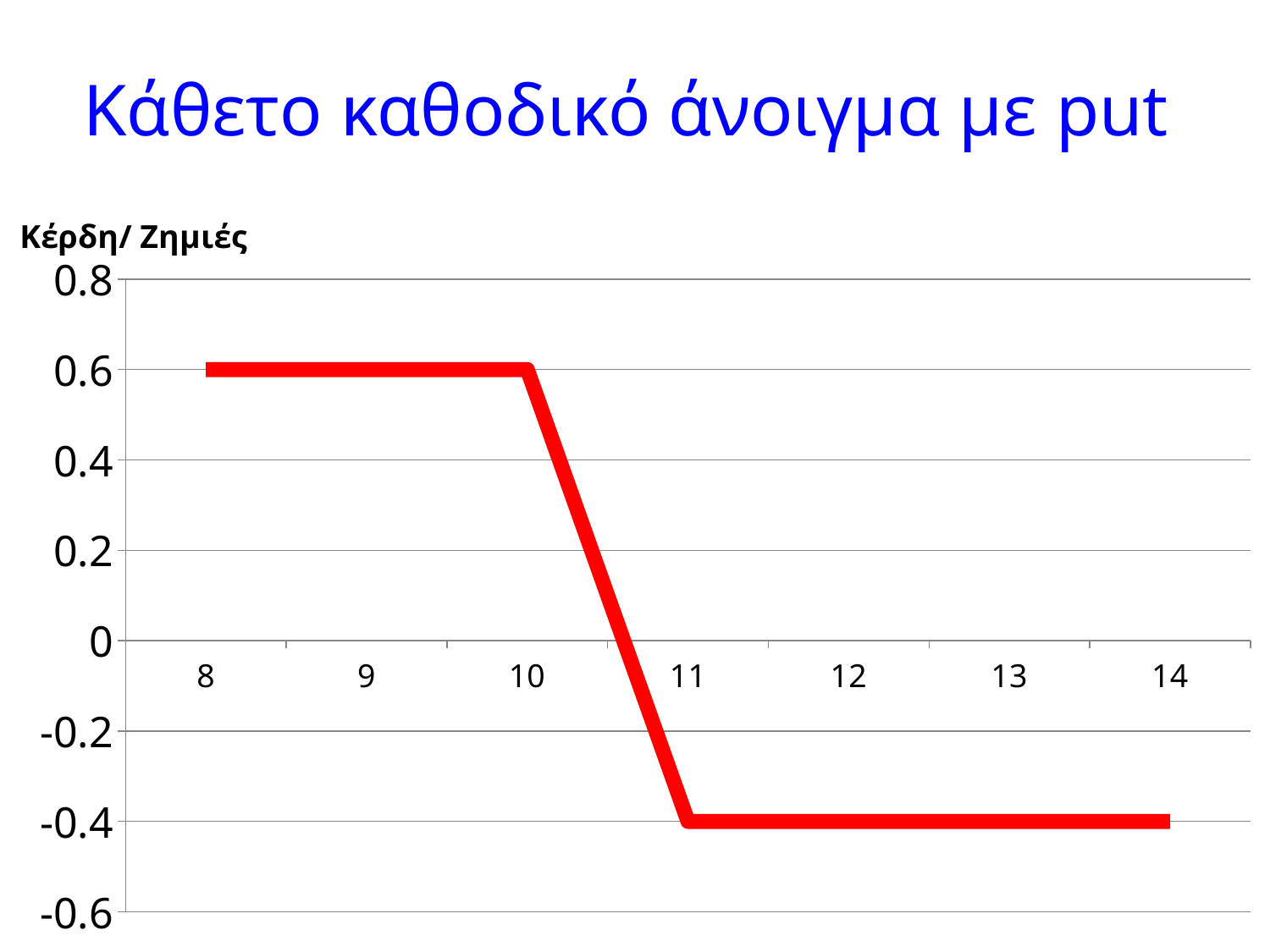
What is the value of the line at x = 11? -0.4 What is the value of the line at x = 14? -0.4 What kind of chart is shown on the slide? line chart Is the value at x = 9 greater or less than 0.4? greater What is the label of the y axis? Κέρδη/ Ζημιές Which is larger, the value at x = 9 or the value at x = 12? x = 9 Is the value at x = 13 greater or less than 0? less What is the value of the line at x = 8? 0.6 Does the line rise or fall between x = 10 and x = 11? fall How many labelled tick marks are on the x axis? 7 What is the value of the line at x = 10? 0.6 What is the difference between the value at x = 10 and the value at x = 11? 1